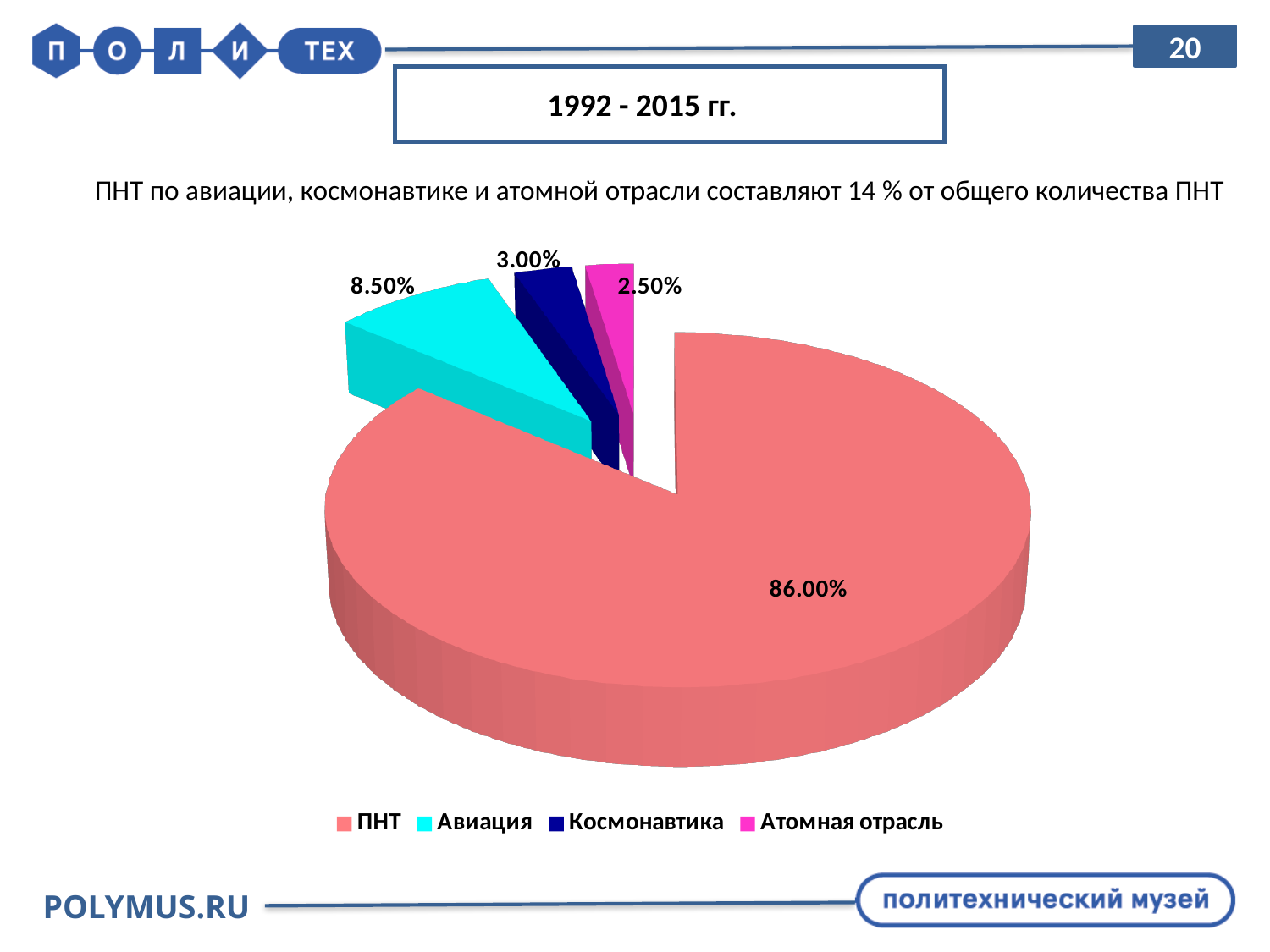
What is the combined value of Авиация, Космонавтика and Атомная отрасль? 14.00% What is the value for Атомная отрасль? 2.50% What is the value for ПНТ? 86.00% What is the value for Космонавтика? 3.00% What colour is the slice for Авиация? cyan How many categories does the legend list? 4 Which is larger, Космонавтика or Атомная отрасль? Космонавтика What is the value for Авиация? 8.50% Which category has the smallest slice? Атомная отрасль What kind of chart is shown on the slide? pie chart What is the difference between the values for Авиация and Космонавтика? 5.50% Which category has the largest slice? ПНТ